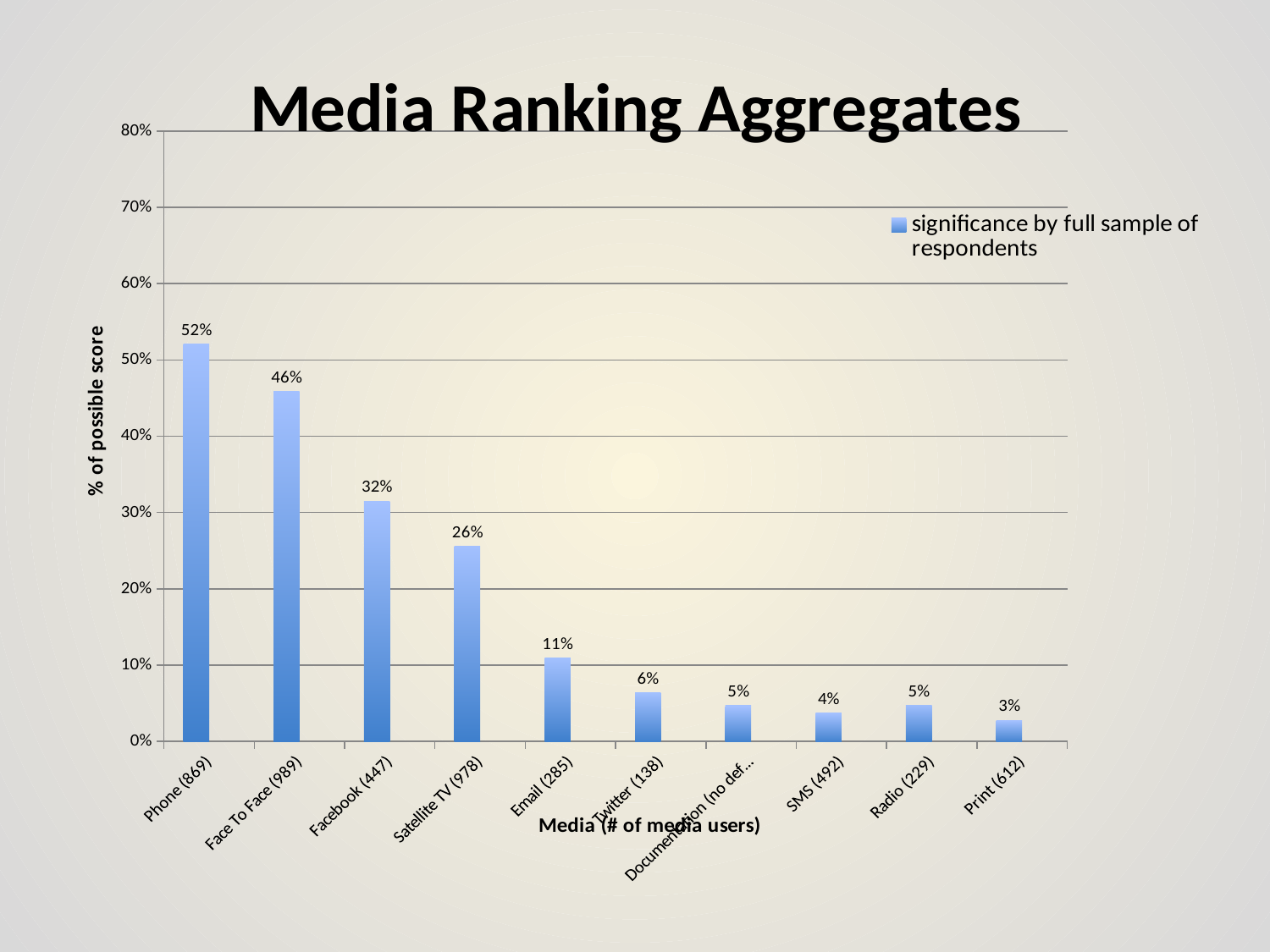
What kind of chart is shown on the slide? bar chart What is the value for Phone (869)? 52% Which category has the lowest value? Print (612) Is the value for Face To Face (989) greater or less than 40%? greater What is the value for Email (285)? 11% What is the title of the chart? Media Ranking Aggregates How many categories are shown on the x axis? 10 Which category has the highest value? Phone (869) What is the difference between the values for Phone (869) and Face To Face (989)? 6% Which is larger, the value for Facebook (447) or the value for Satellite TV (978)? Facebook (447) What is the value for Satellite TV (978)? 26% How many series does the legend list? 1